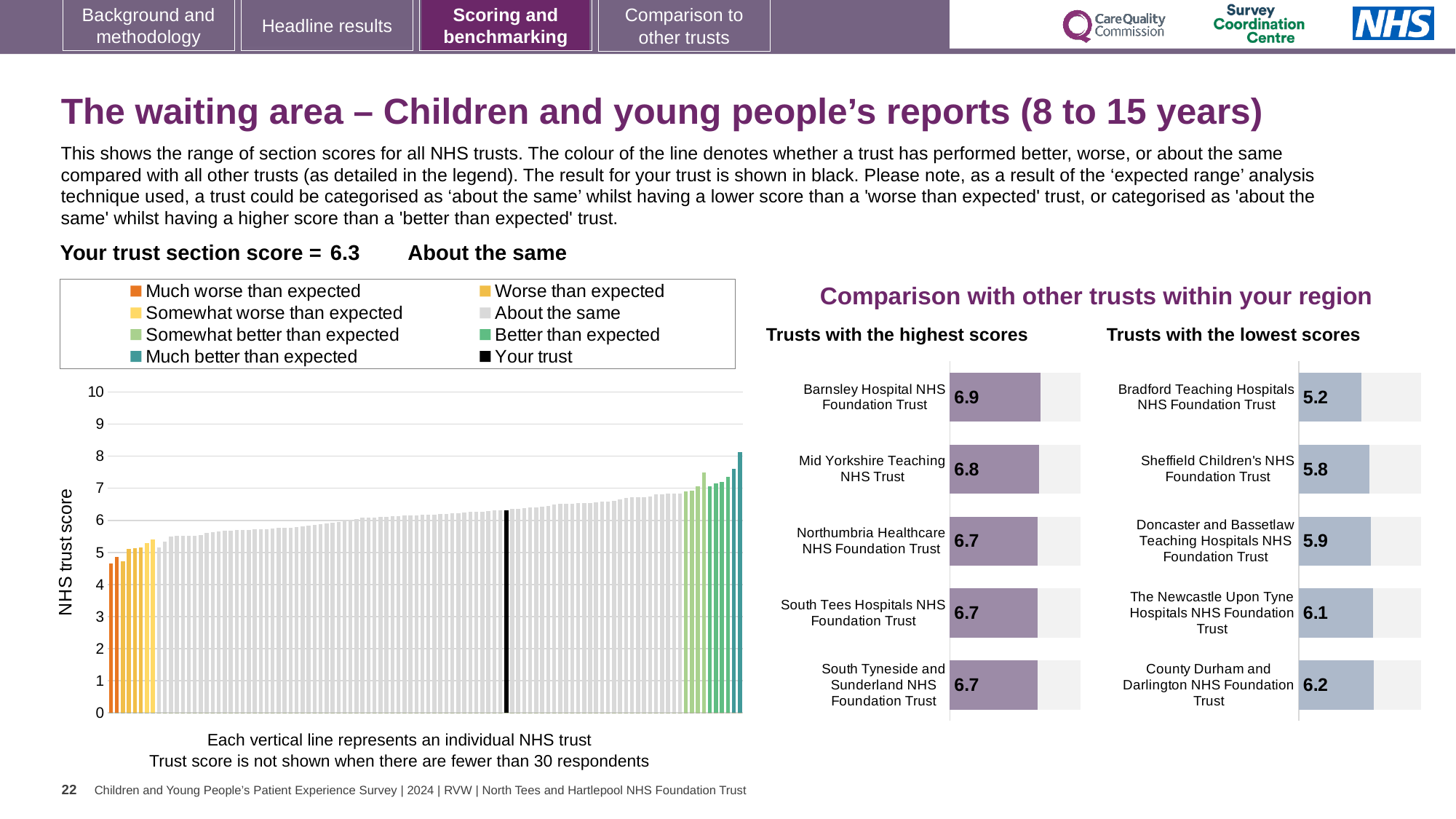
On the 'Trusts with the lowest scores' chart, what is the score for Bradford Teaching Hospitals NHS Foundation Trust? 5.2 On the 'Trusts with the lowest scores' chart, what is the difference between the scores of County Durham and Darlington NHS Foundation Trust and Bradford Teaching Hospitals NHS Foundation Trust? 1.0 On the 'Trusts with the highest scores' chart, how many trusts are shown? 5 On the 'Trusts with the highest scores' chart, which trust has the highest score? Barnsley Hospital NHS Foundation Trust On the 'Trusts with the lowest scores' chart, which trust has the lowest score? Bradford Teaching Hospitals NHS Foundation Trust How many entries does the legend above the main 'NHS trust score' chart list? 8 On the main 'NHS trust score' chart on the left, is the value for the lowest-scoring trust greater or less than 5? less On the 'Trusts with the lowest scores' chart, which has the larger score: Sheffield Children's NHS Foundation Trust or Doncaster and Bassetlaw Teaching Hospitals NHS Foundation Trust? Doncaster and Bassetlaw Teaching Hospitals NHS Foundation Trust On the 'Trusts with the highest scores' chart, what is the score for Barnsley Hospital NHS Foundation Trust? 6.9 What kind of chart is the main 'NHS trust score' chart on the left? bar chart On the 'Trusts with the highest scores' chart, what is the difference between the scores of Barnsley Hospital NHS Foundation Trust and Mid Yorkshire Teaching NHS Trust? 0.1 On the main 'NHS trust score' chart on the left, do the trust scores rise or fall from left to right? rise